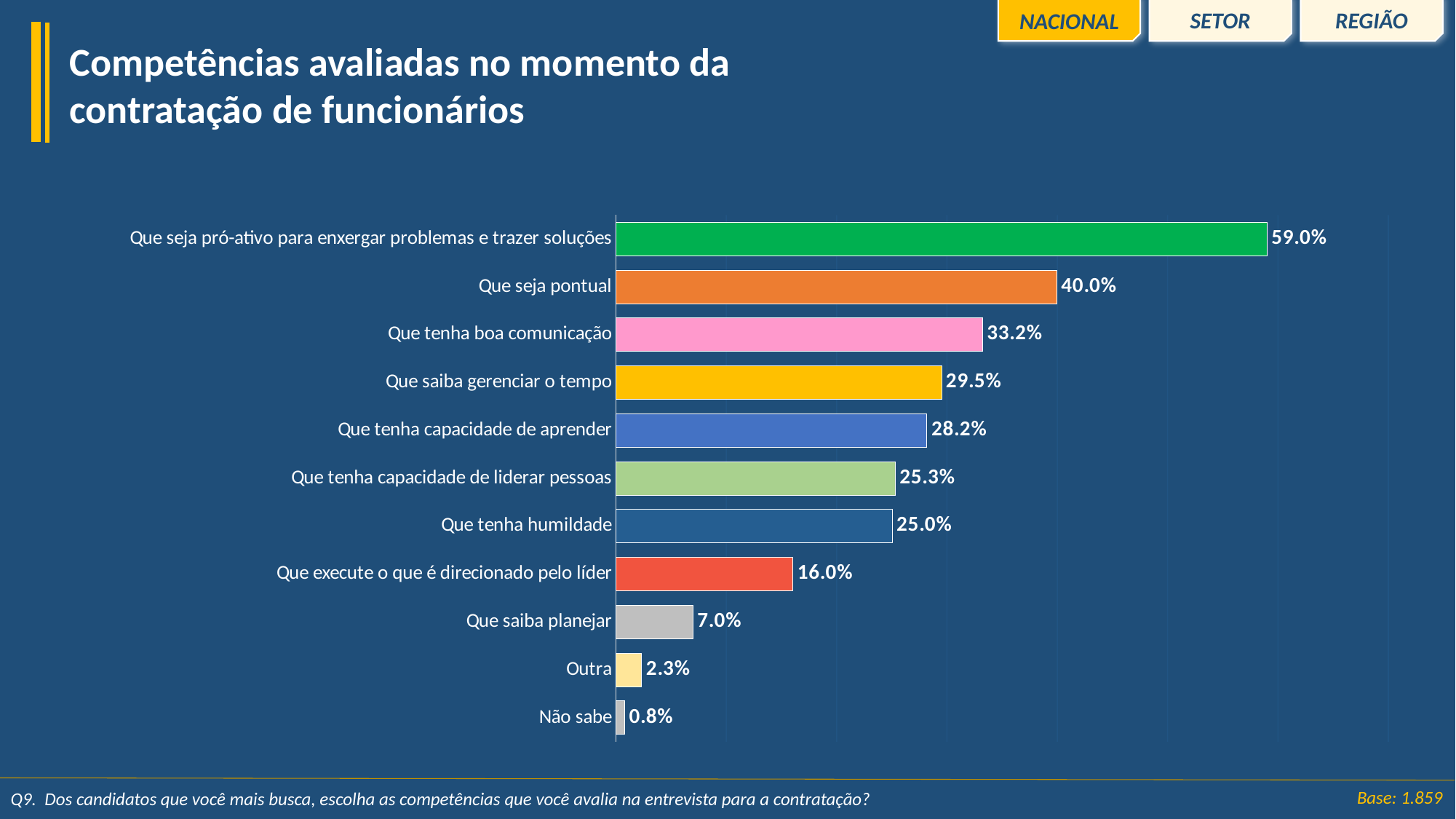
Which category has the lowest value? Não sabe What is the value for "Outra"? 2.3% What is the value for "Que saiba planejar"? 7.0% What is the difference between "Que tenha boa comunicação" and "Que saiba gerenciar o tempo"? 3.7% What kind of chart is shown on the slide? Bar chart What is the value for "Que seja pontual"? 40.0% How many categories are shown in the chart? 11 Which is larger: "Que tenha capacidade de aprender" or "Que tenha humildade"? Que tenha capacidade de aprender What is the difference between "Que seja pró-ativo para enxergar problemas e trazer soluções" and "Que seja pontual"? 19.0% What is the title of the chart on the slide? Competências avaliadas no momento da contratação de funcionários What is the value for "Que tenha capacidade de liderar pessoas"? 25.3% Which category has the highest value? Que seja pró-ativo para enxergar problemas e trazer soluções